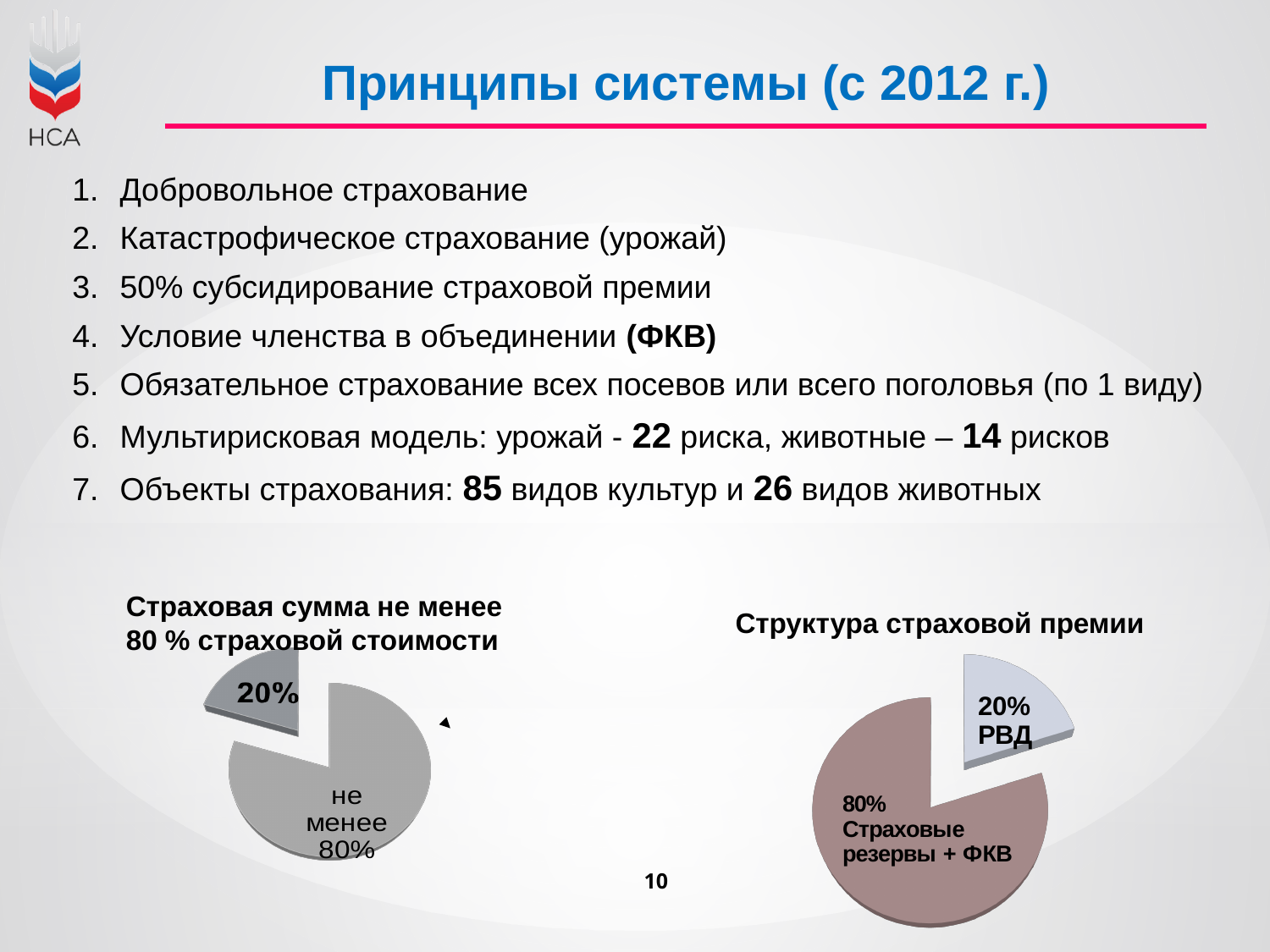
In the left pie chart ("Страховая сумма не менее 80 % страховой стоимости"), what label is printed on the larger slice? не менее 80% In the "Структура страховой премии" chart, which slice is the smallest? РВД In the "Структура страховой премии" chart, what is the difference in percentage points between the "Страховые резервы + ФКВ" slice and the РВД slice? 60 In the "Структура страховой премии" chart, how many slices does the pie have? 2 In the left pie chart ("Страховая сумма не менее 80 % страховой стоимости"), what value is printed on the smaller, separated slice? 20% In the "Структура страховой премии" chart, what share of the premium is labelled РВД? 20% In the "Структура страховой премии" chart, which slice is the largest? Страховые резервы + ФКВ In the "Структура страховой премии" chart, what share is labelled "Страховые резервы + ФКВ"? 80% In the left pie chart ("Страховая сумма не менее 80 % страховой стоимости"), how many slices are there? 2 In the "Структура страховой премии" chart, which slice is larger: РВД or "Страховые резервы + ФКВ"? Страховые резервы + ФКВ What kind of chart is shown under the heading "Структура страховой премии"? pie chart What kind of chart is shown under the heading "Страховая сумма не менее 80 % страховой стоимости"? pie chart